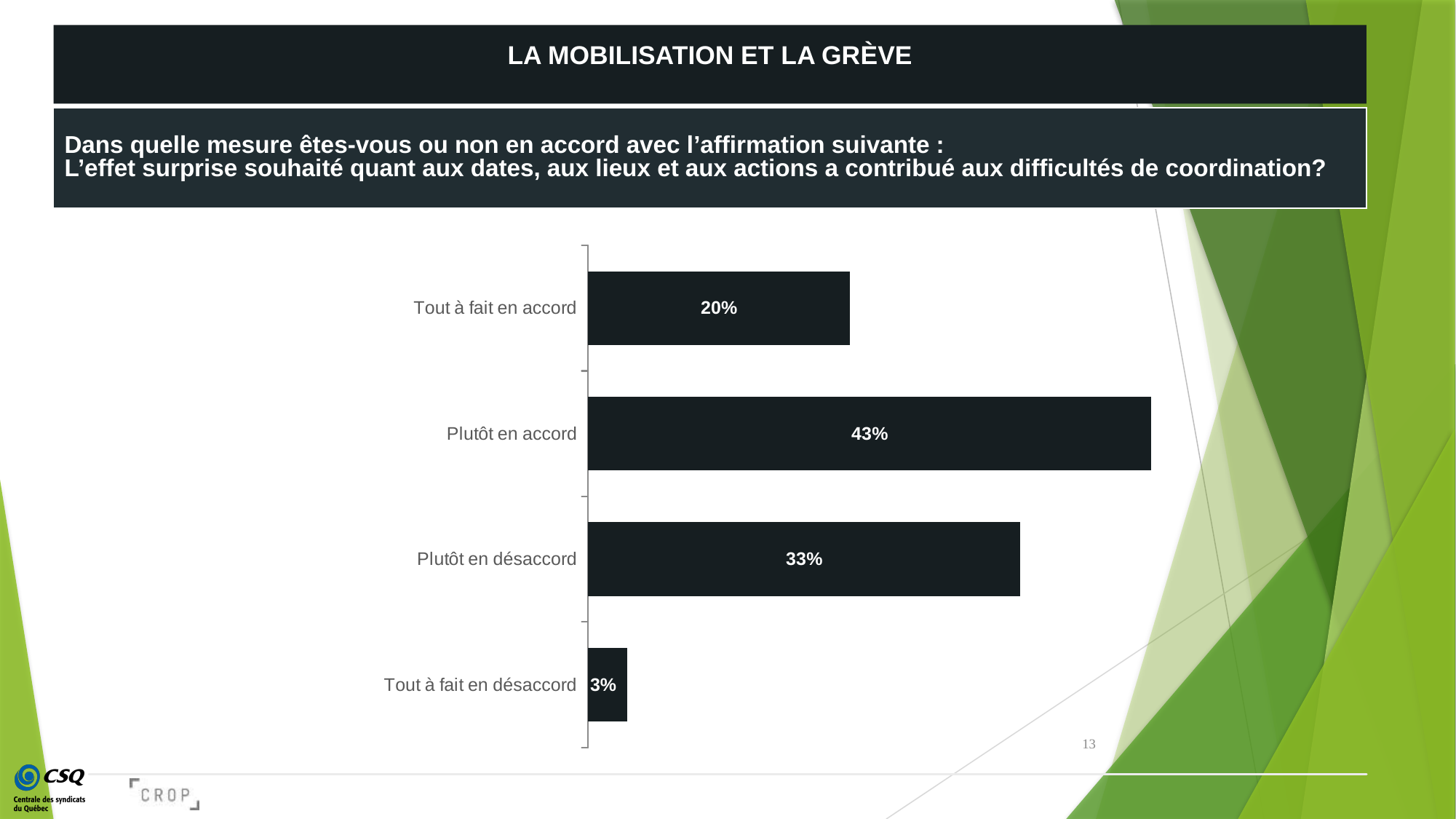
What kind of chart is shown on the slide? Bar chart How many categories are shown in the chart? 4 What is the value for "Plutôt en accord"? 43% What is the difference between the values for "Plutôt en accord" and "Plutôt en désaccord"? 10% Which category has the highest value? Plutôt en accord Which category has the lowest value? Tout à fait en désaccord What is the value for "Plutôt en désaccord"? 33% What is the combined value of "Tout à fait en accord" and "Plutôt en accord"? 63% What is the value for "Tout à fait en accord"? 20% What is the value for "Tout à fait en désaccord"? 3% What is the difference between the values for "Tout à fait en accord" and "Tout à fait en désaccord"? 17% Which is larger, the value for "Tout à fait en accord" or the value for "Plutôt en désaccord"? Plutôt en désaccord